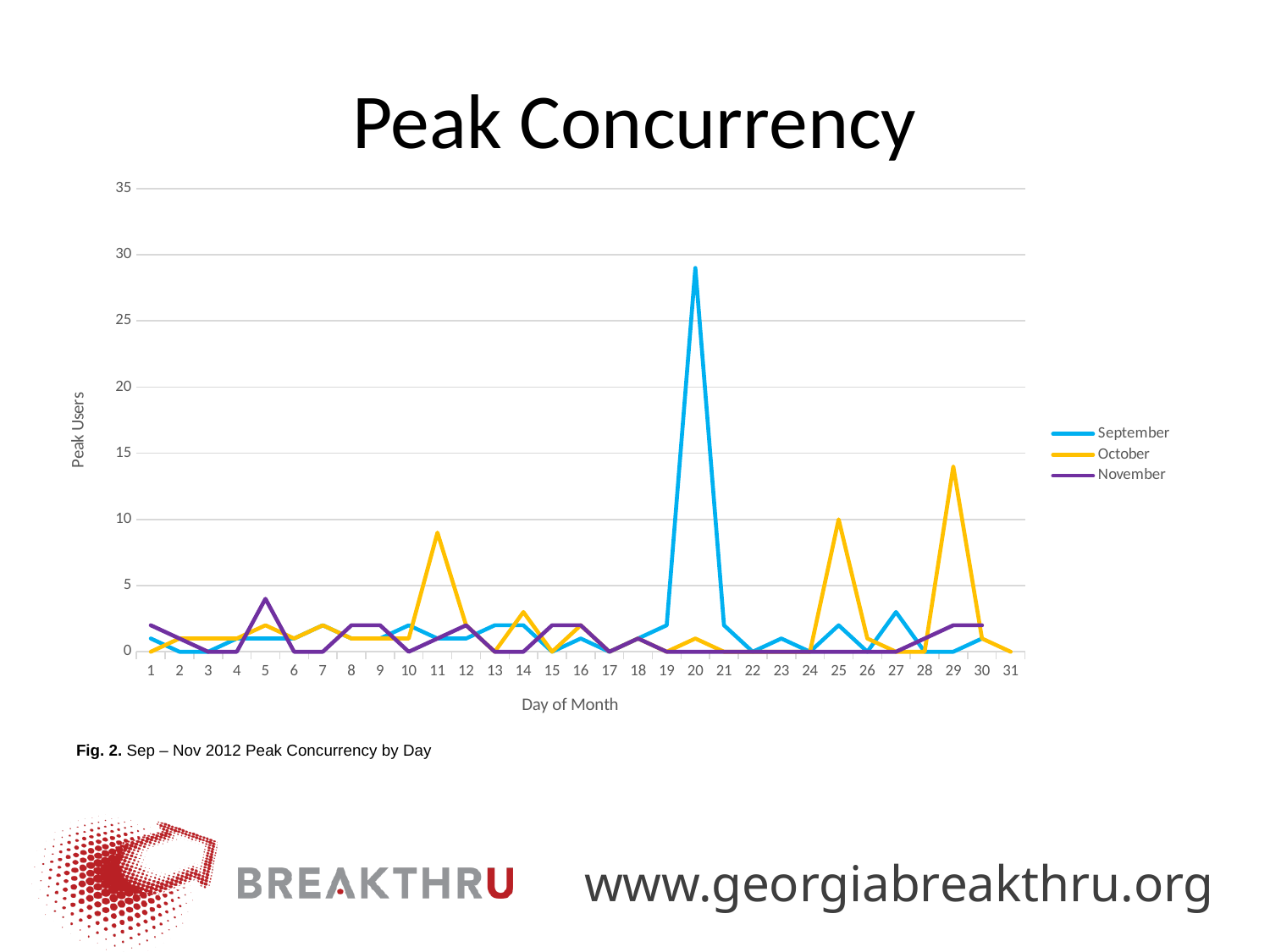
What is the title of the chart? Peak Concurrency What is the November value on day 20? 0 Is the September value on day 20 greater or less than 25? greater Which is larger: the September value on day 20 or the October value on day 29? September value on day 20 How many series does the legend list? 3 Which series are listed in the legend? September, October, November Which series reaches the highest peak value on the chart? September Is the November value on day 5 greater or less than 5? less What kind of chart is shown on the slide? line chart Is the October value on day 11 greater or less than 5? greater How many days are shown along the x axis? 31